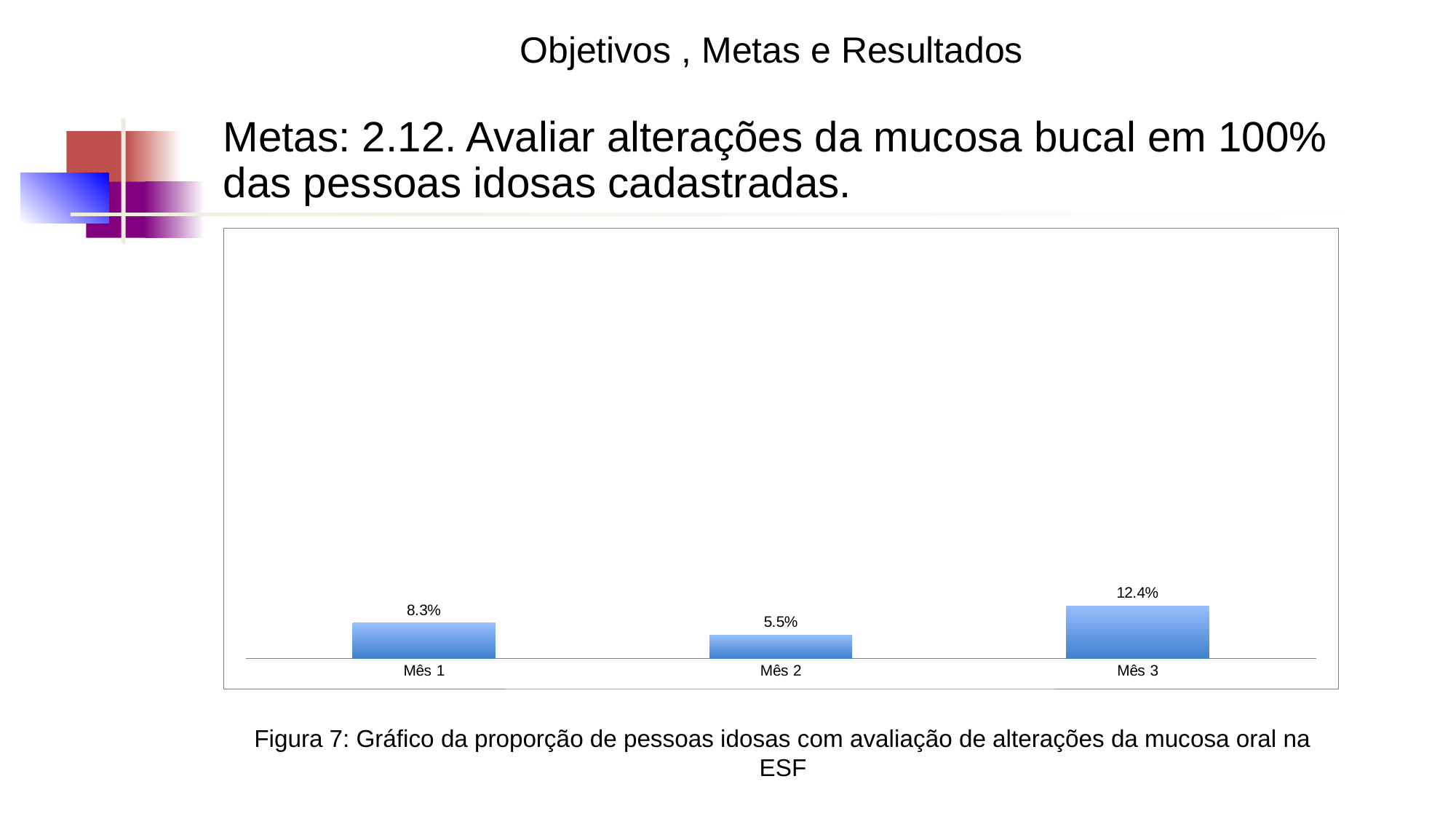
What is the difference between the values for Mês 1 and Mês 2? 2.8% What is the difference between the values for Mês 3 and Mês 1? 4.1% What is the figure caption below the chart? Figura 7: Gráfico da proporção de pessoas idosas com avaliação de alterações da mucosa oral na ESF Which month has the highest value? Mês 3 How many months are shown on the chart? 3 What is the value for Mês 2? 5.5% Which month has the lowest value? Mês 2 Which is larger, the value for Mês 1 or the value for Mês 2? Mês 1 What kind of chart is shown on the slide? Bar chart What is the value for Mês 1? 8.3% What is the value for Mês 3? 12.4% Does the value rise or fall from Mês 2 to Mês 3? Rise